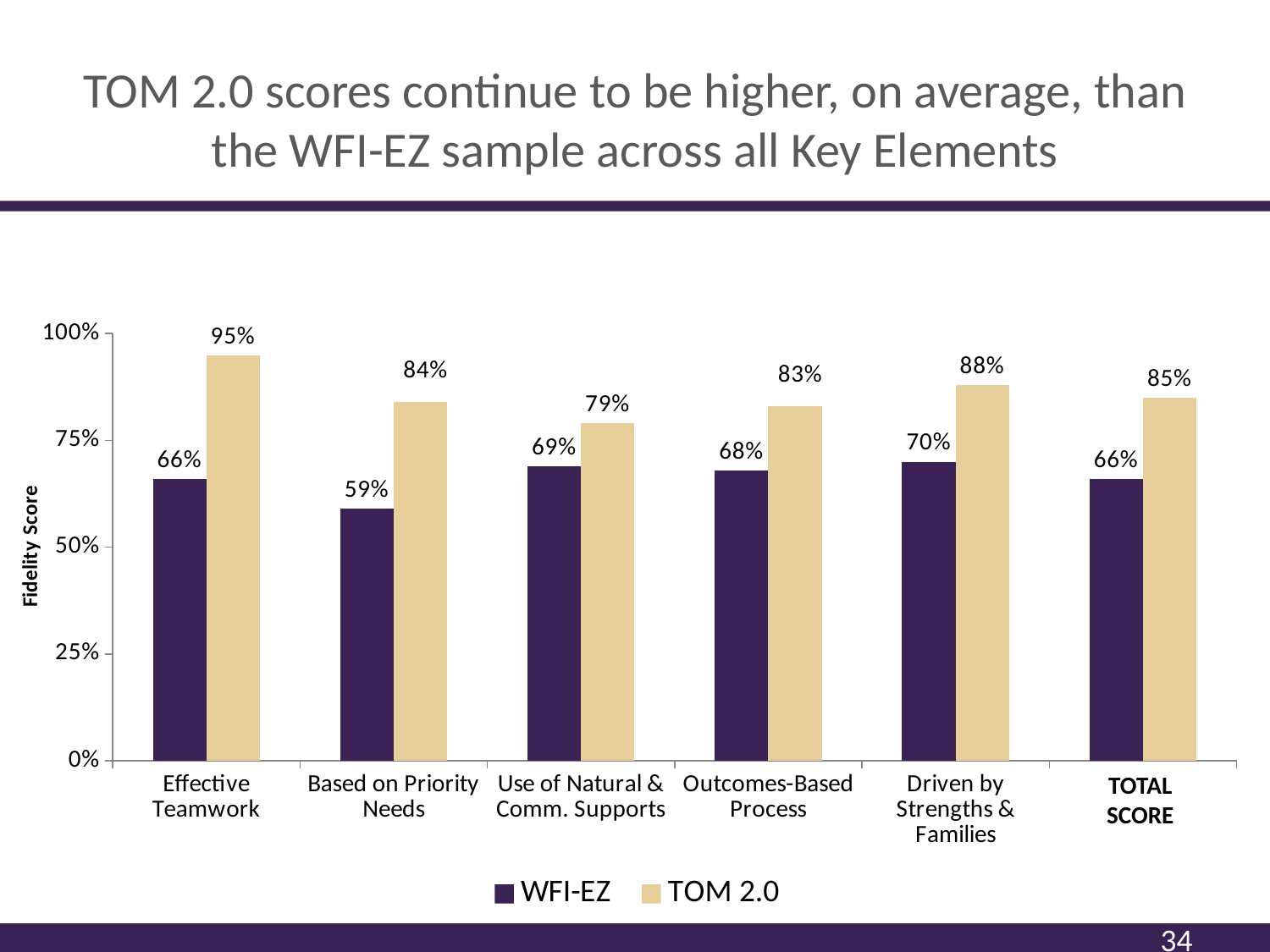
Which is larger for Outcomes-Based Process, the WFI-EZ value or the TOM 2.0 value? TOM 2.0 How many categories are shown on the x axis? 6 Which category has the highest TOM 2.0 value? Effective Teamwork Which category has the lowest WFI-EZ value? Based on Priority Needs What is the TOM 2.0 value for Effective Teamwork? 95% What is the WFI-EZ value for Based on Priority Needs? 59% What is the difference between the TOM 2.0 and WFI-EZ values for Effective Teamwork? 29% What kind of chart is shown on the slide? bar chart What is the TOM 2.0 value for Driven by Strengths & Families? 88% How many series does the legend list? 2 What is the WFI-EZ value for TOTAL SCORE? 66% Is the WFI-EZ value for Use of Natural & Comm. Supports greater or less than 75%? less